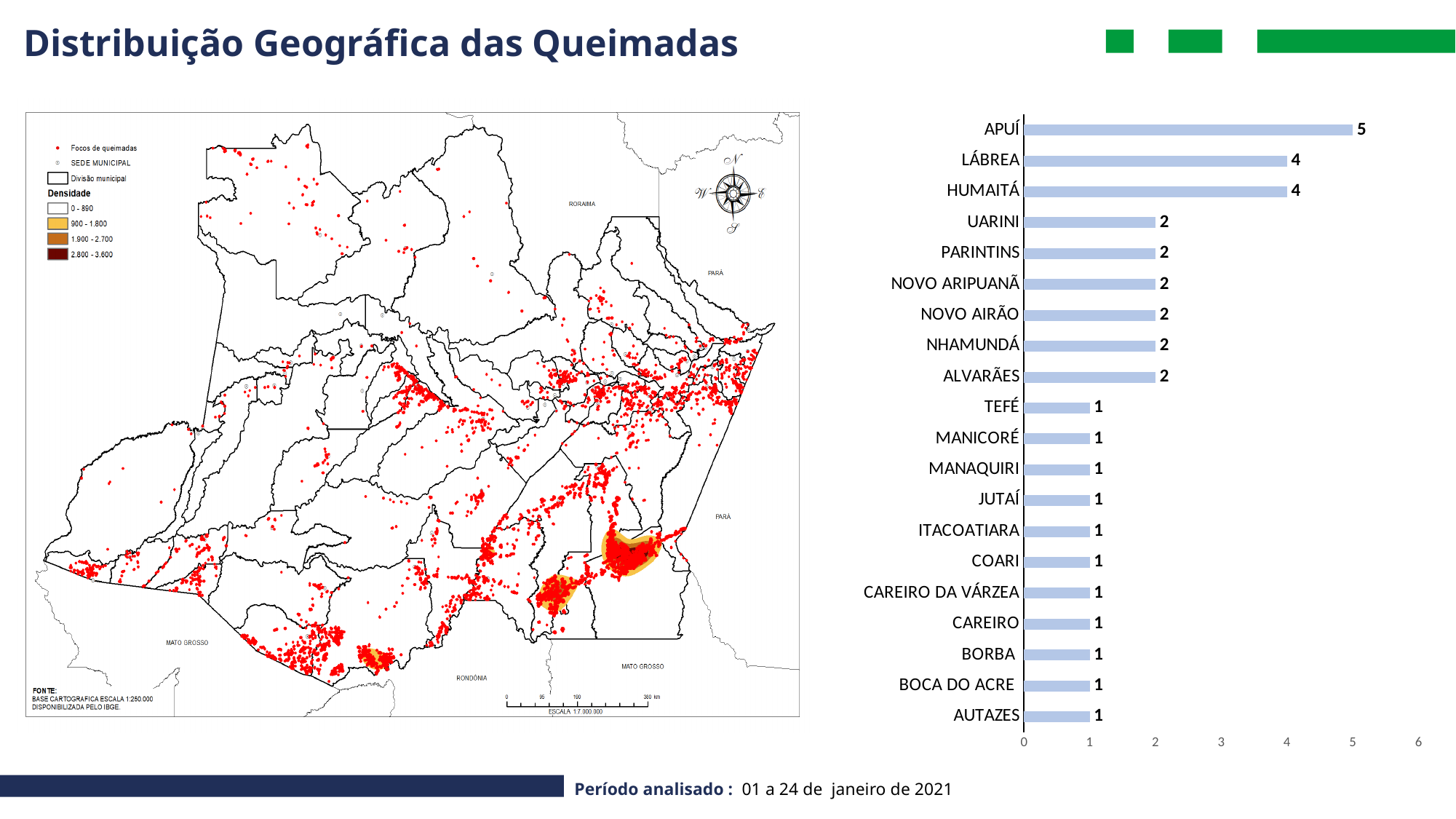
How many municipalities are listed in the bar chart? 20 In the bar chart, which municipality has the highest value? APUÍ In the bar chart, what is the difference between the values for HUMAITÁ and UARINI? 2 What type of chart is shown on the right side of the slide? bar chart In the bar chart, what is the value for APUÍ? 5 In the bar chart, what is the value for HUMAITÁ? 4 In the bar chart, what is the value for BOCA DO ACRE? 1 In the bar chart, what is the value for NOVO ARIPUANÃ? 2 What is the title of the slide? Distribuição Geográfica das Queimadas In the bar chart, which has a larger value, PARINTINS or TEFÉ? PARINTINS In the bar chart, is the value for LÁBREA greater or less than 3? greater In the bar chart, what is the difference between the values for APUÍ and LÁBREA? 1